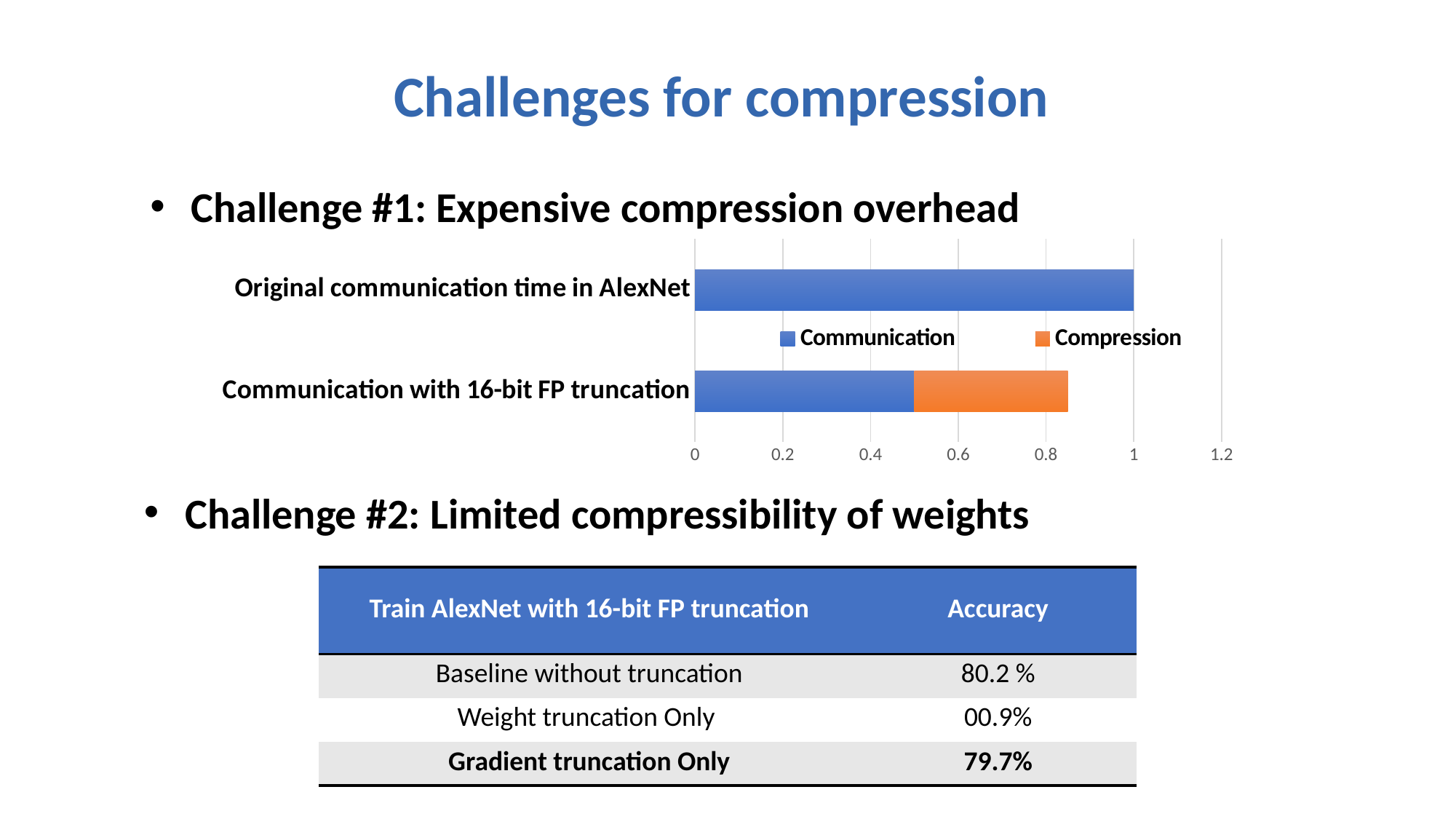
Is the Communication segment of the Communication with 16-bit FP truncation bar greater or less than 0.4? greater Which category has the longer total bar in the chart? Original communication time in AlexNet Is the total for Original communication time in AlexNet larger or smaller than the total for Communication with 16-bit FP truncation? larger Which category has the shorter total bar in the chart? Communication with 16-bit FP truncation Which colour represents Compression in the chart? orange What are the two series named in the chart legend? Communication and Compression What kind of chart is shown under Challenge #1? bar chart Is the total bar for Communication with 16-bit FP truncation greater or less than 1? less How many series does the legend of the chart list? 2 Is the total bar for Communication with 16-bit FP truncation greater or less than 0.6? greater What is the value of the bar for Original communication time in AlexNet? 1 How many categories (bars) does the chart under Challenge #1 show? 2